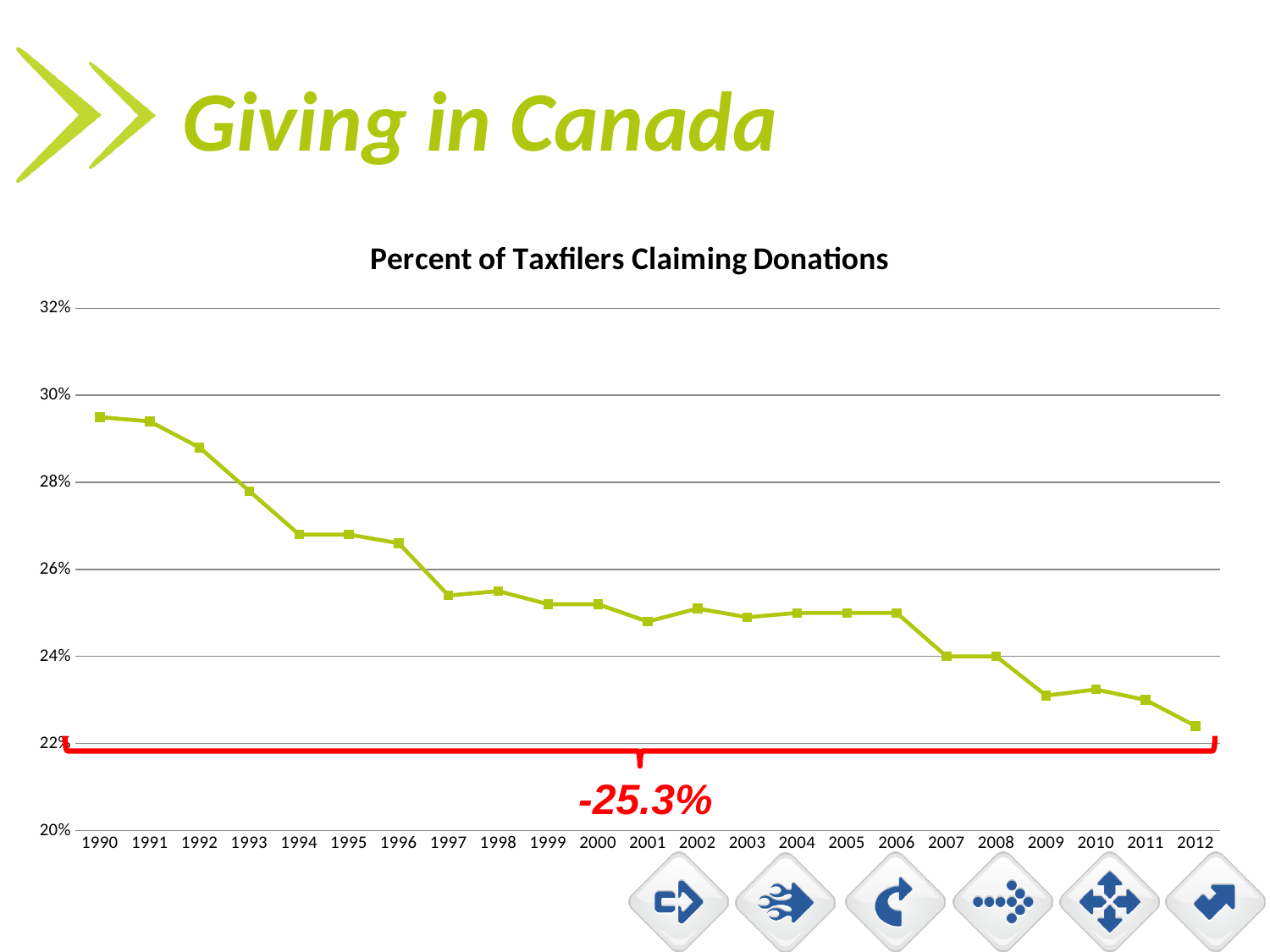
Is the value for 1990 greater or less than 28%? greater What is the title of the chart? Percent of Taxfilers Claiming Donations How many years are plotted along the x axis of the chart? 23 Is the value for 2012 greater or less than 24%? less Is the value for 1997 greater or less than 26%? less What overall percentage change is annotated in red below the chart? -25.3% Do the values in the chart generally rise or fall from 1990 to 2012? fall Which year has the highest percent of taxfilers claiming donations? 1990 Which year has the lowest percent of taxfilers claiming donations? 2012 What kind of chart is shown on the slide? line chart Which year has a higher value, 1992 or 1997? 1992